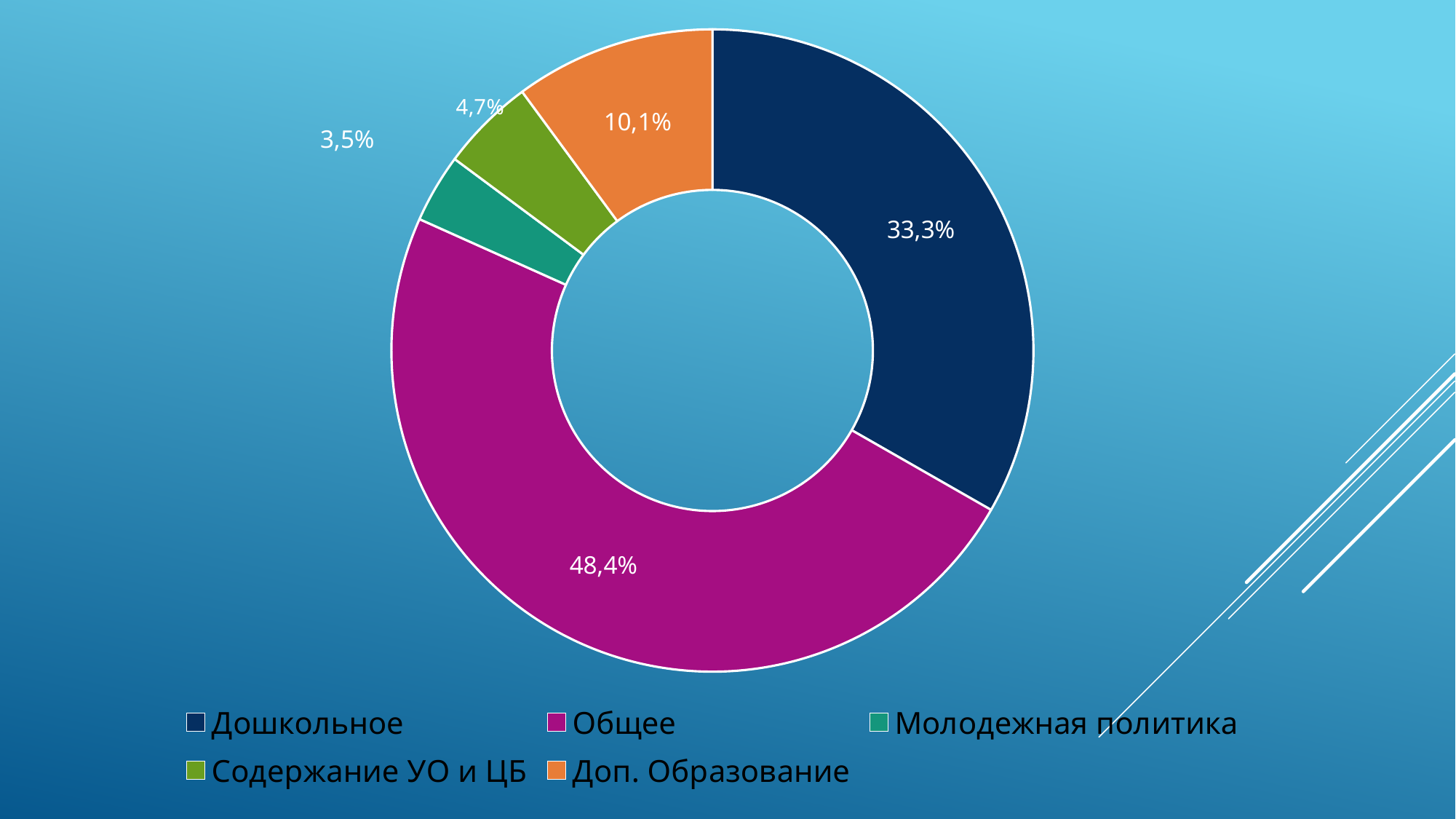
What share of the doughnut chart does Общее account for? 48,4% Which category has the smallest share of the chart? Молодежная политика What percentage is shown for Содержание УО и ЦБ? 4,7% Which is larger, the share for Доп. Образование or the share for Содержание УО и ЦБ? Доп. Образование What is the difference in percentage points between Общее and Дошкольное? 15,1 What colour is the slice for Общее? Magenta What percentage is shown for Дошкольное? 33,3% What value is labelled for Доп. Образование? 10,1% Which category has the largest share of the chart? Общее What percentage is shown for Молодежная политика? 3,5% How many categories are shown in the chart? 5 What type of chart is shown on the slide? Doughnut chart